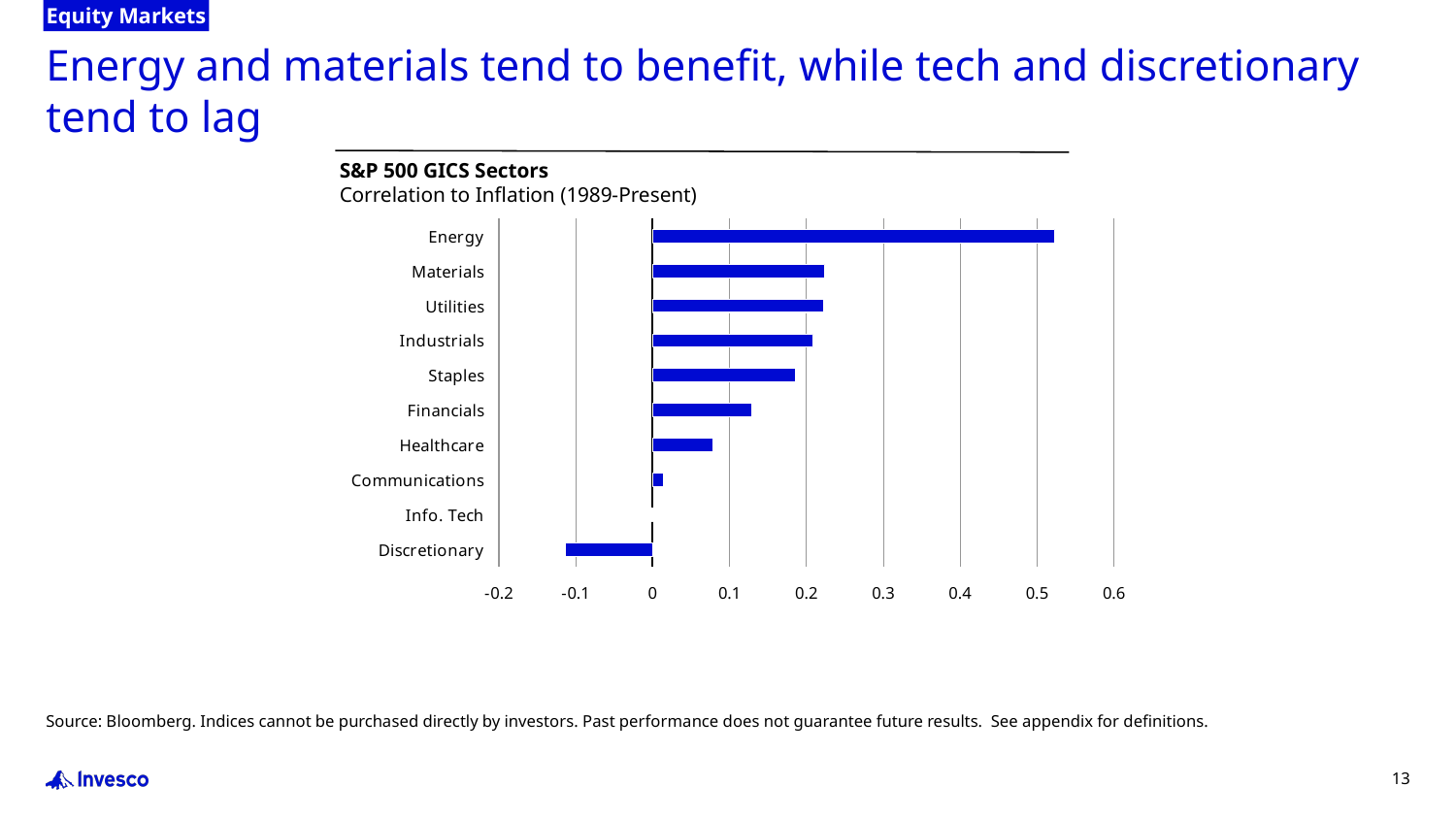
What is the title of the chart? S&P 500 GICS Sectors Is the value for Materials greater or less than 0.3? less Which has a higher correlation to inflation, Staples or Healthcare? Staples What kind of chart is shown on the slide? bar chart How many sectors are plotted in the chart? 10 Which sector has the highest correlation to inflation? Energy Which sector has the lowest correlation to inflation? Discretionary Is the value for Discretionary greater or less than 0? less Is the value for Energy greater or less than 0.5? greater Which has a higher correlation to inflation, Energy or Materials? Energy